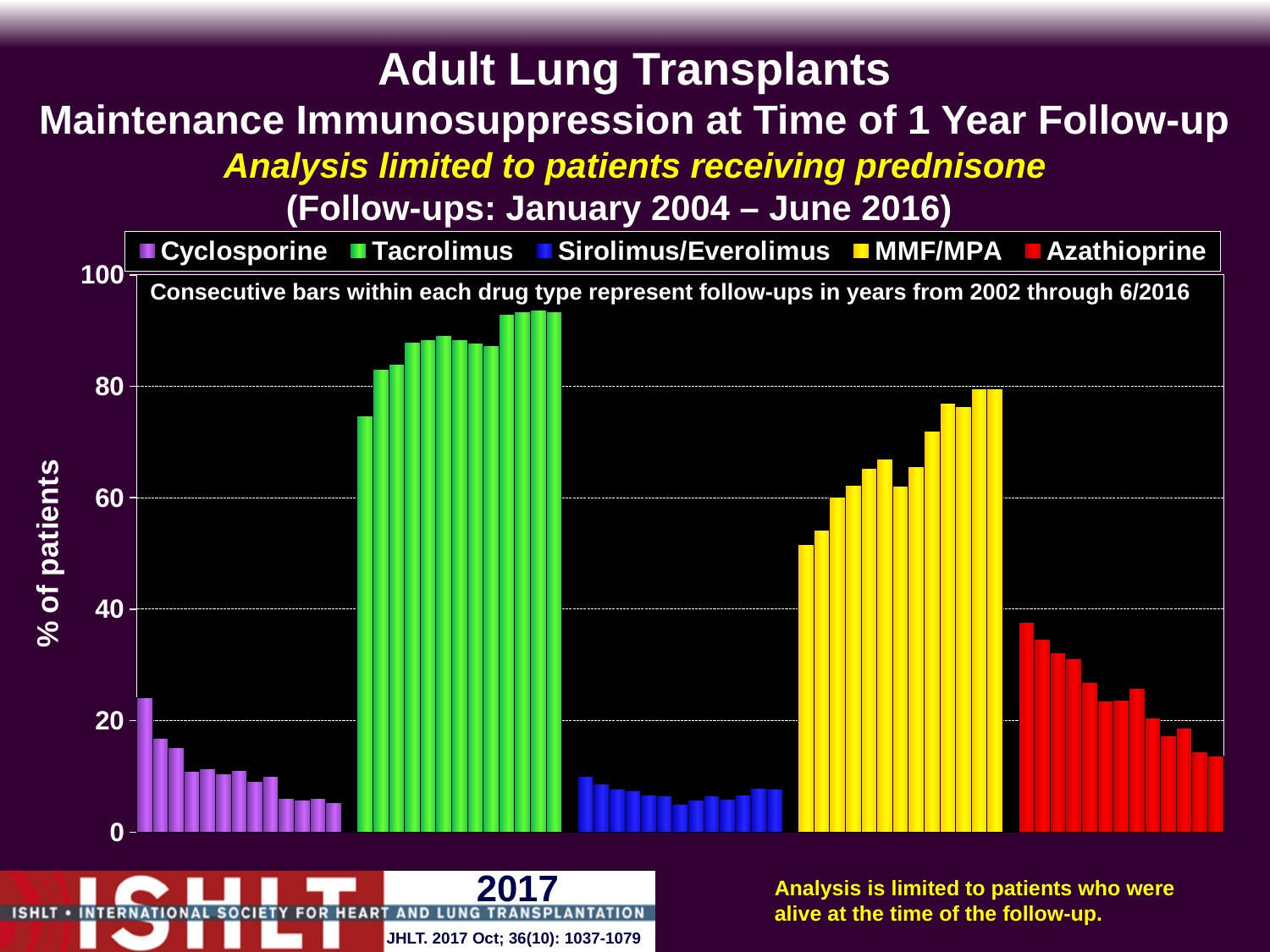
Do the MMF/MPA bars generally rise or fall across the follow-up years from left to right? rise How many drug types (series) does the legend list? 5 Is the tallest Tacrolimus bar greater or less than 80? greater Are all of the Sirolimus/Everolimus bars greater or less than 20? less Which drug type has the lowest bars in the chart? Sirolimus/Everolimus What is the label on the y axis of the chart? % of patients Is the tallest MMF/MPA bar greater or less than 60? greater Which colour represents Tacrolimus in the chart? green Which drug type has the highest bars in the chart? Tacrolimus Do the Cyclosporine bars generally rise or fall across the follow-up years from left to right? fall What kind of chart is shown on the slide? bar chart